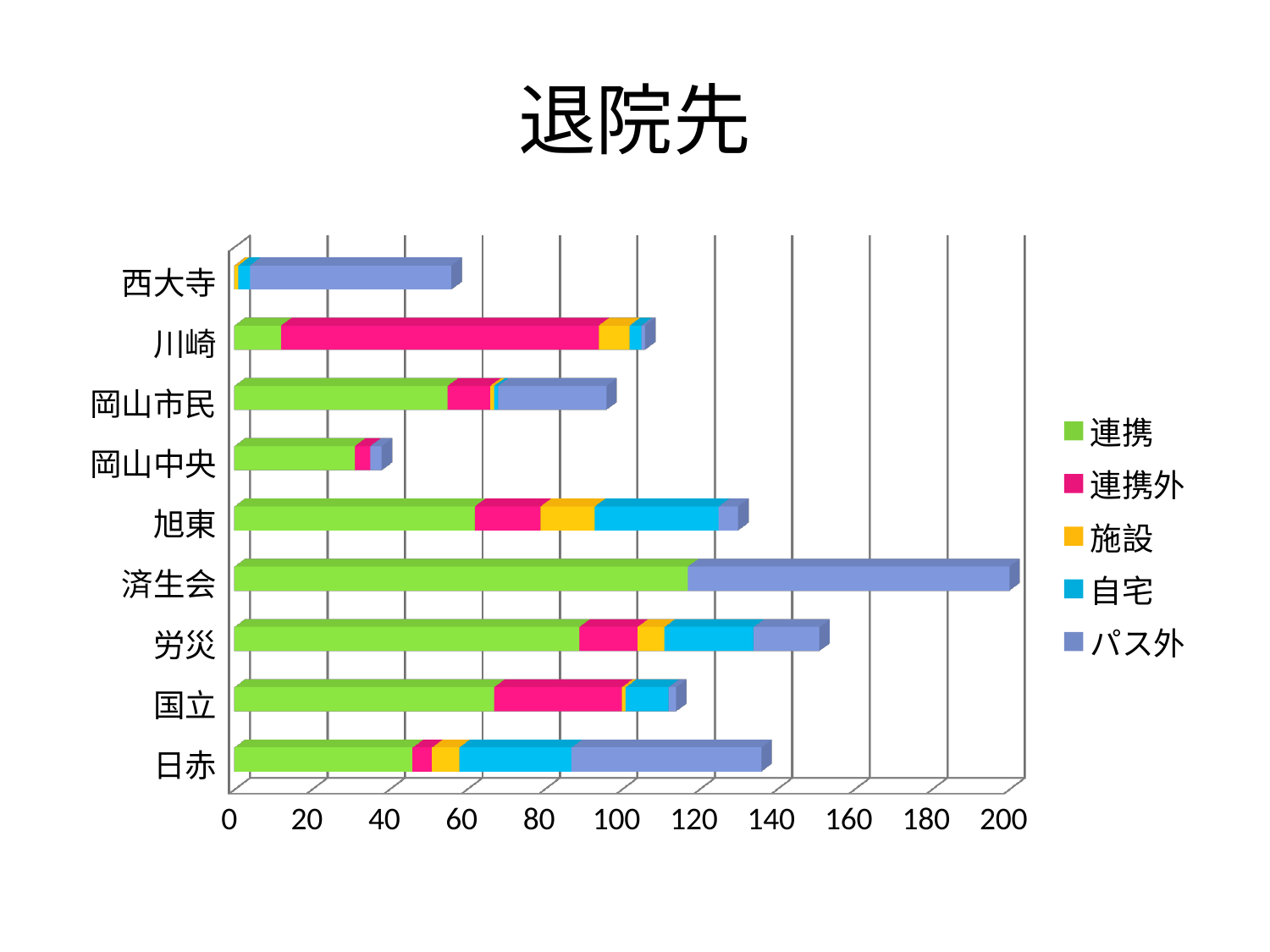
How many series does the legend list? 5 Which hospital has the shortest total stacked bar? 岡山中央 Which has the longer total bar, 労災 or 国立? 労災 How many hospitals (categories) are shown on the y axis? 9 Is the total bar length for 西大寺 greater or less than 80? less Is the total bar length for 労災 greater or less than 140? greater Which series makes up the largest part of the bar for 西大寺? パス外 Is the total bar length for 岡山中央 greater or less than 60? less Which hospital has the longest total stacked bar? 済生会 What is the title of the chart? 退院先 What kind of chart is shown on the slide? bar chart